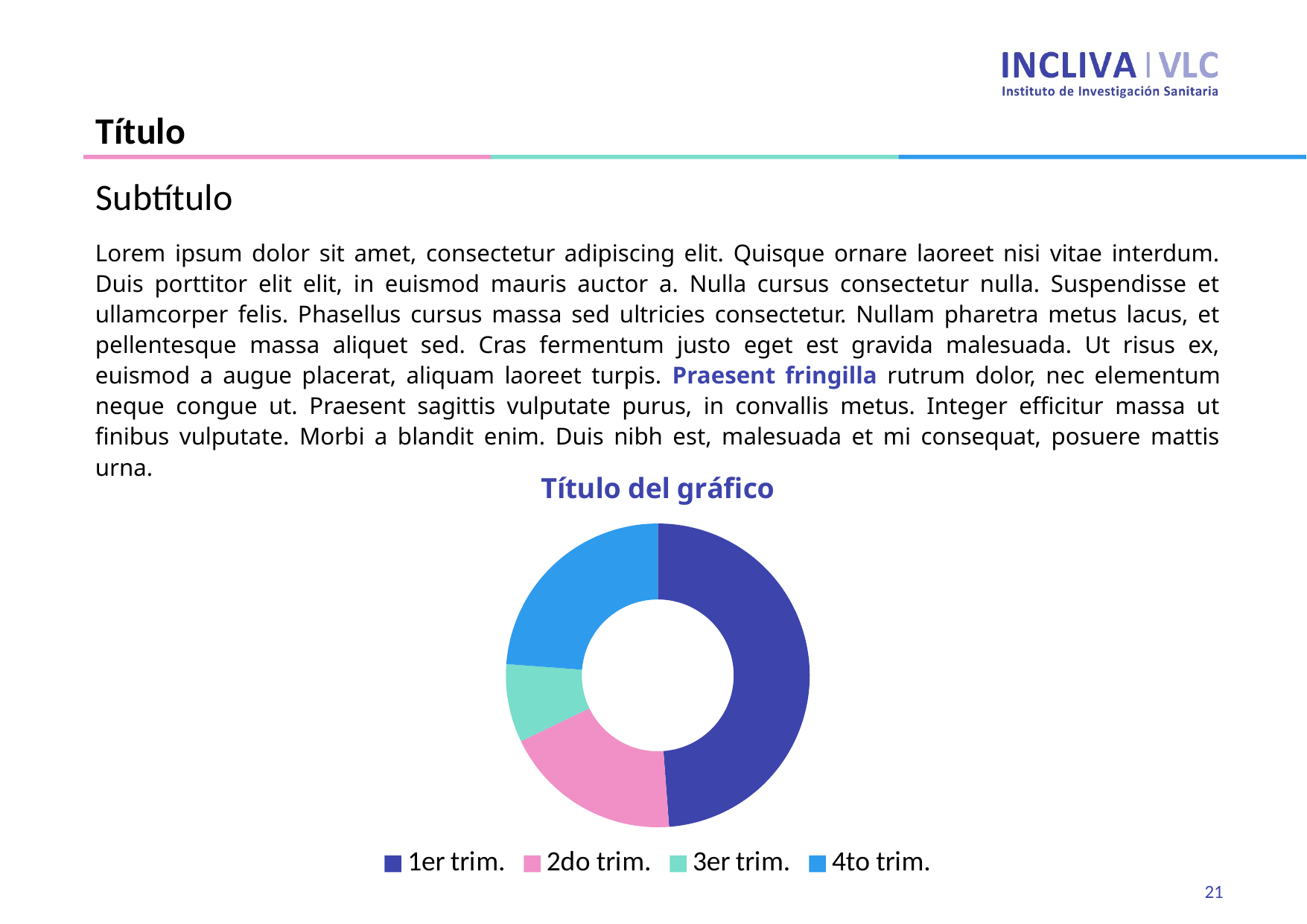
How many categories does the doughnut chart show? 4 What kind of chart is shown on the slide? Doughnut chart Which category has the largest slice in the chart? 1er trim. Which category has the smallest slice in the chart? 3er trim. Which slice is larger, 1er trim. or 2do trim.? 1er trim. Which slice is larger, 4to trim. or 2do trim.? 4to trim. Which slice is larger, 2do trim. or 3er trim.? 2do trim. How many entries does the chart legend list? 4 What is the title of the chart? Título del gráfico What colour represents 2do trim. in the chart? Pink